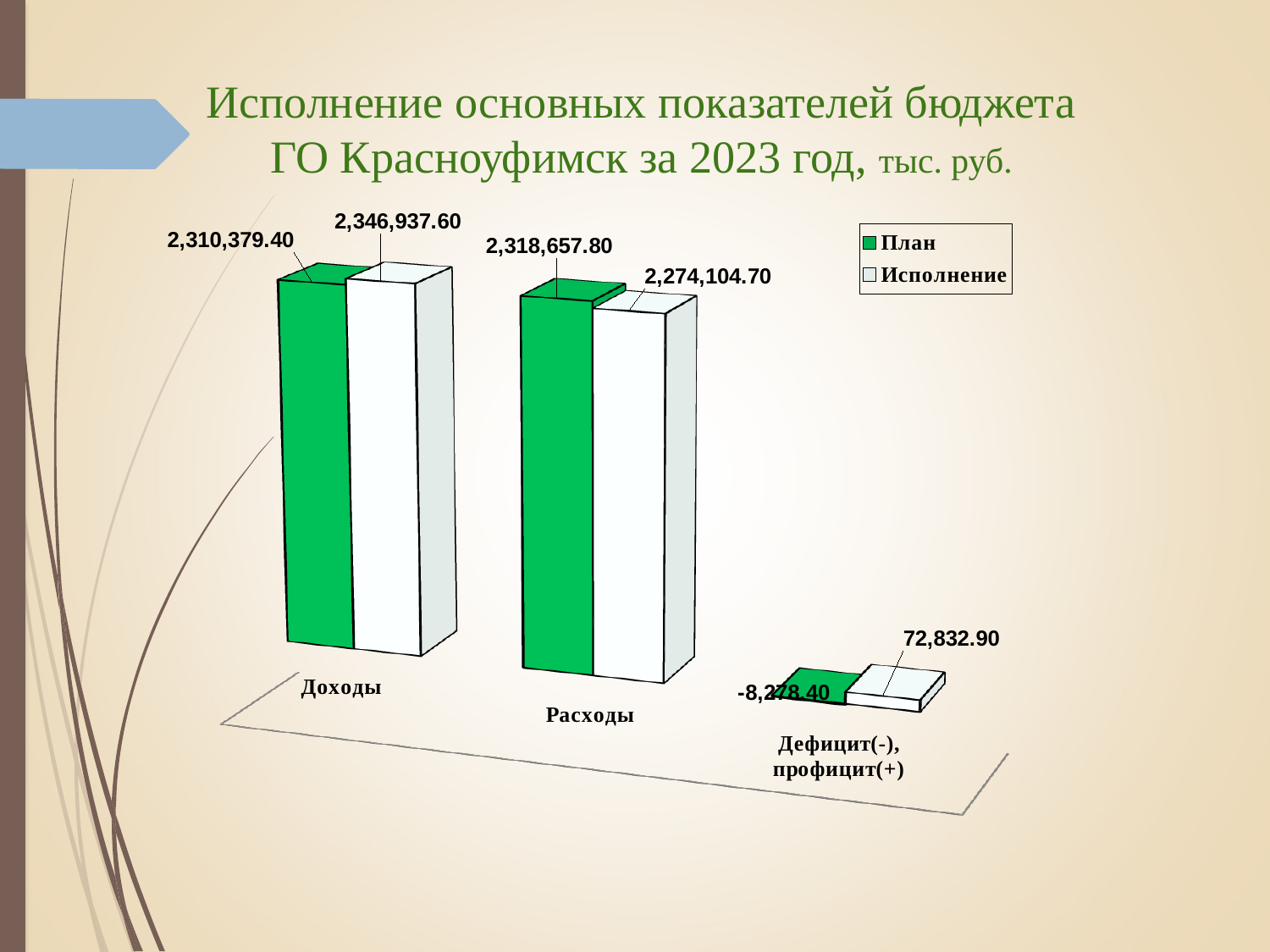
How many categories are shown on the chart? 3 What kind of chart is shown on the slide? Bar chart For Расходы, which is larger: План or Исполнение? План What is the difference between the Исполнение and План values for Доходы? 36,558.20 What is the Исполнение value for Доходы? 2,346,937.60 What is the План value for Расходы? 2,318,657.80 For Доходы, which is larger: План or Исполнение? Исполнение What is the Исполнение value for Дефицит(-), профицит(+)? 72,832.90 What is the Исполнение value for Расходы? 2,274,104.70 How many series does the legend list? 2 What is the План value for Доходы? 2,310,379.40 What is the difference between the План and Исполнение values for Расходы? 44,553.10